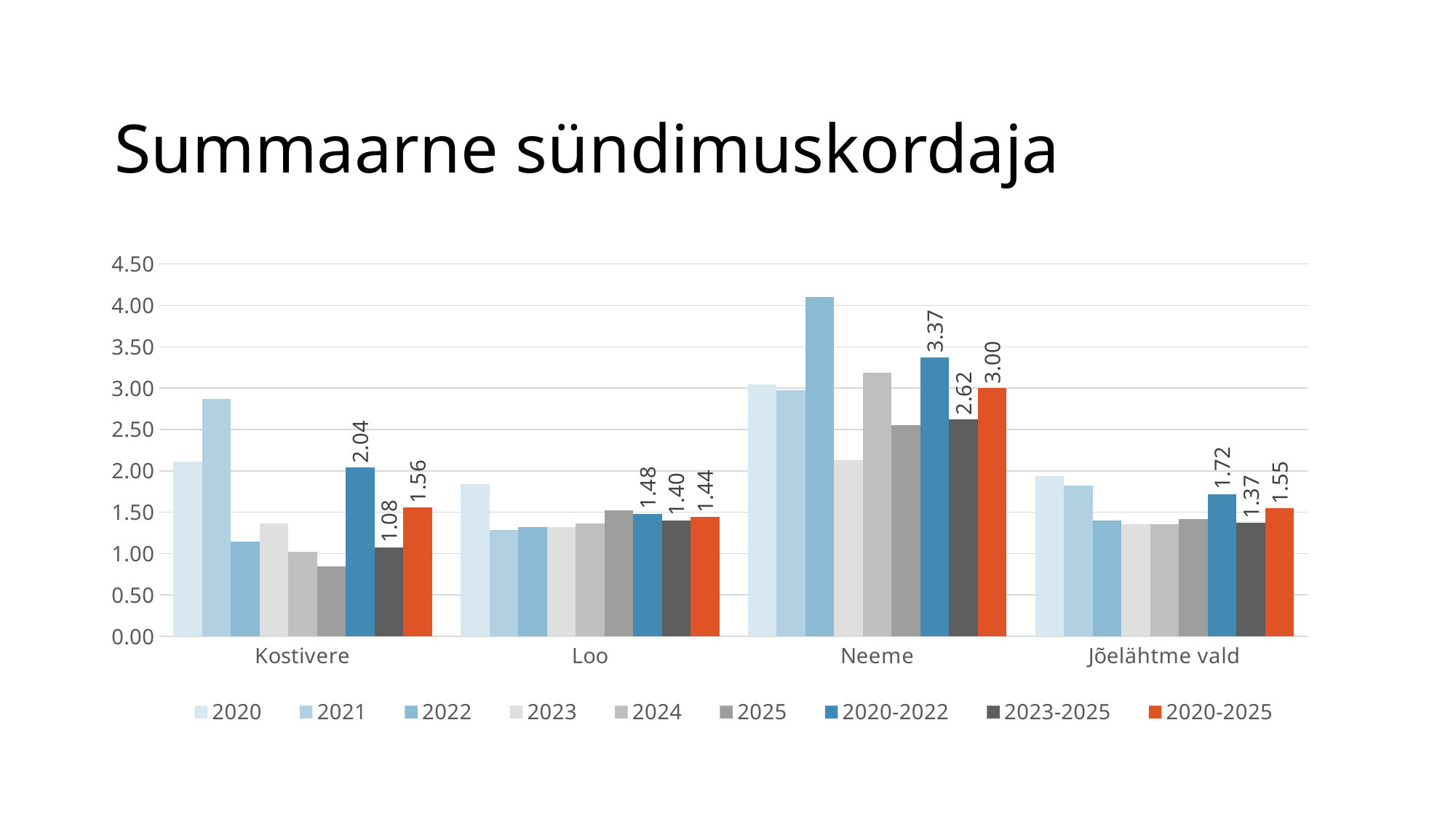
Which category has the lowest value in the 2023-2025 series? Kostivere How many series does the legend list? 9 How many categories are shown on the x axis? 4 Which category has the highest value in the 2020-2025 series? Neeme What is the value for Kostivere in the 2023-2025 series? 1.08 What type of chart is shown on the slide? bar chart What is the value for Loo in the 2020-2022 series? 1.48 Is the value for Neeme in the 2022 series greater or less than 4.00? greater What is the difference between the 2020-2022 and 2023-2025 values for Neeme? 0.75 Which is larger for Kostivere: the 2020-2022 value or the 2023-2025 value? 2020-2022 What is the value for Neeme in the 2020-2025 series? 3.00 What is the value for Jõelähtme vald in the 2020-2025 series? 1.55